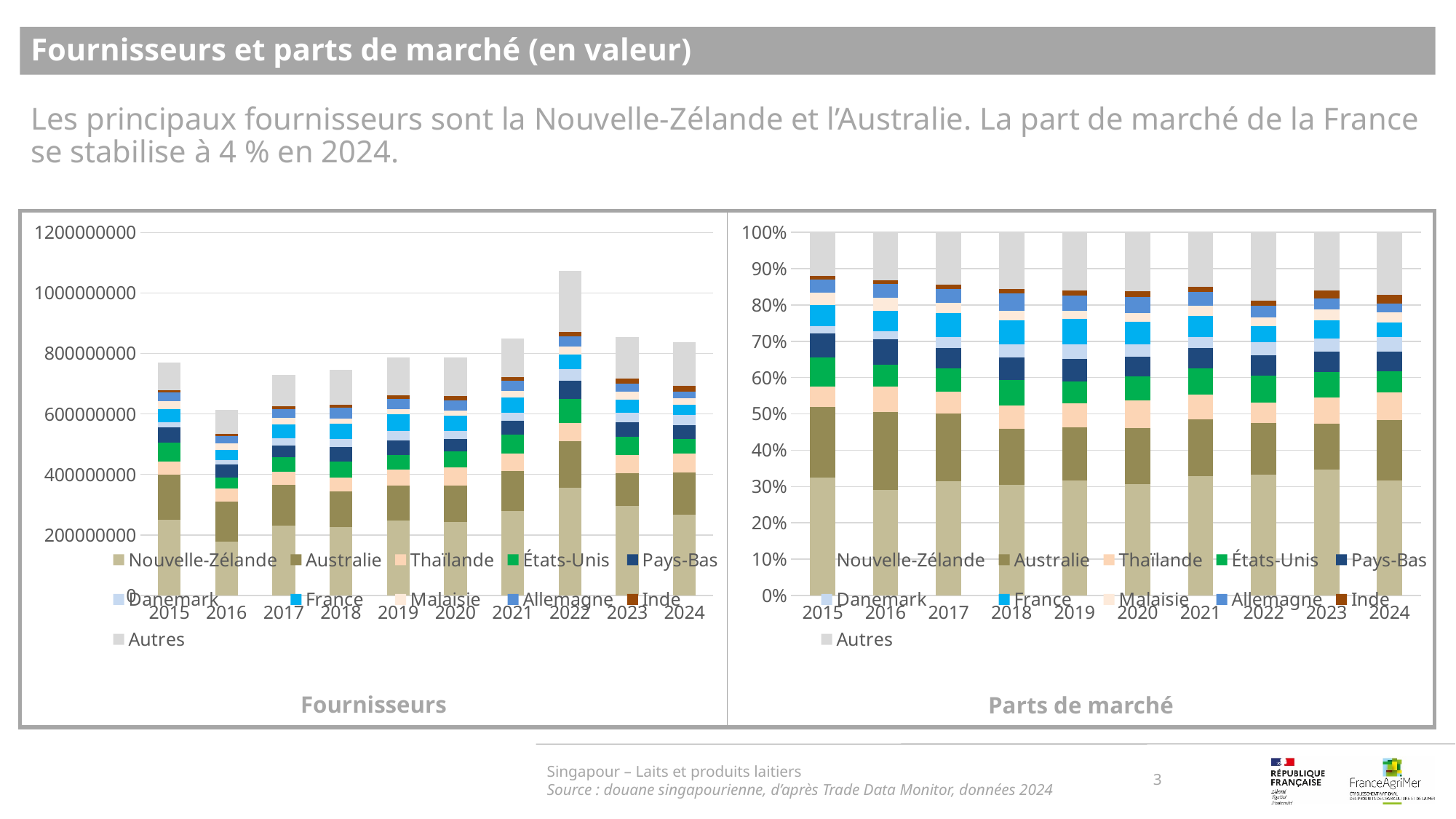
In the 'Fournisseurs' chart, which year has the shortest stacked bar? 2016 In the 'Fournisseurs' chart, is the total for 2017 greater or less than 800000000? less In the 'Fournisseurs' chart, which year has the tallest stacked bar? 2022 What is the title of the chart on the right side of the slide? Parts de marché In the 'Fournisseurs' chart, is the total for 2022 greater or less than 1000000000? greater What kind of chart is the 'Fournisseurs' chart on the left? stacked bar chart How many series does the legend of the 'Parts de marché' chart list? 11 What kind of chart is the 'Parts de marché' chart on the right? stacked bar chart In the 'Fournisseurs' chart, which year has the larger total, 2022 or 2016? 2022 In the 'Fournisseurs' chart, how many years are shown on the x axis? 10 What is the first series listed in the legend of the 'Fournisseurs' chart? Nouvelle-Zélande In the 'Fournisseurs' chart, is the total for 2016 greater or less than 800000000? less